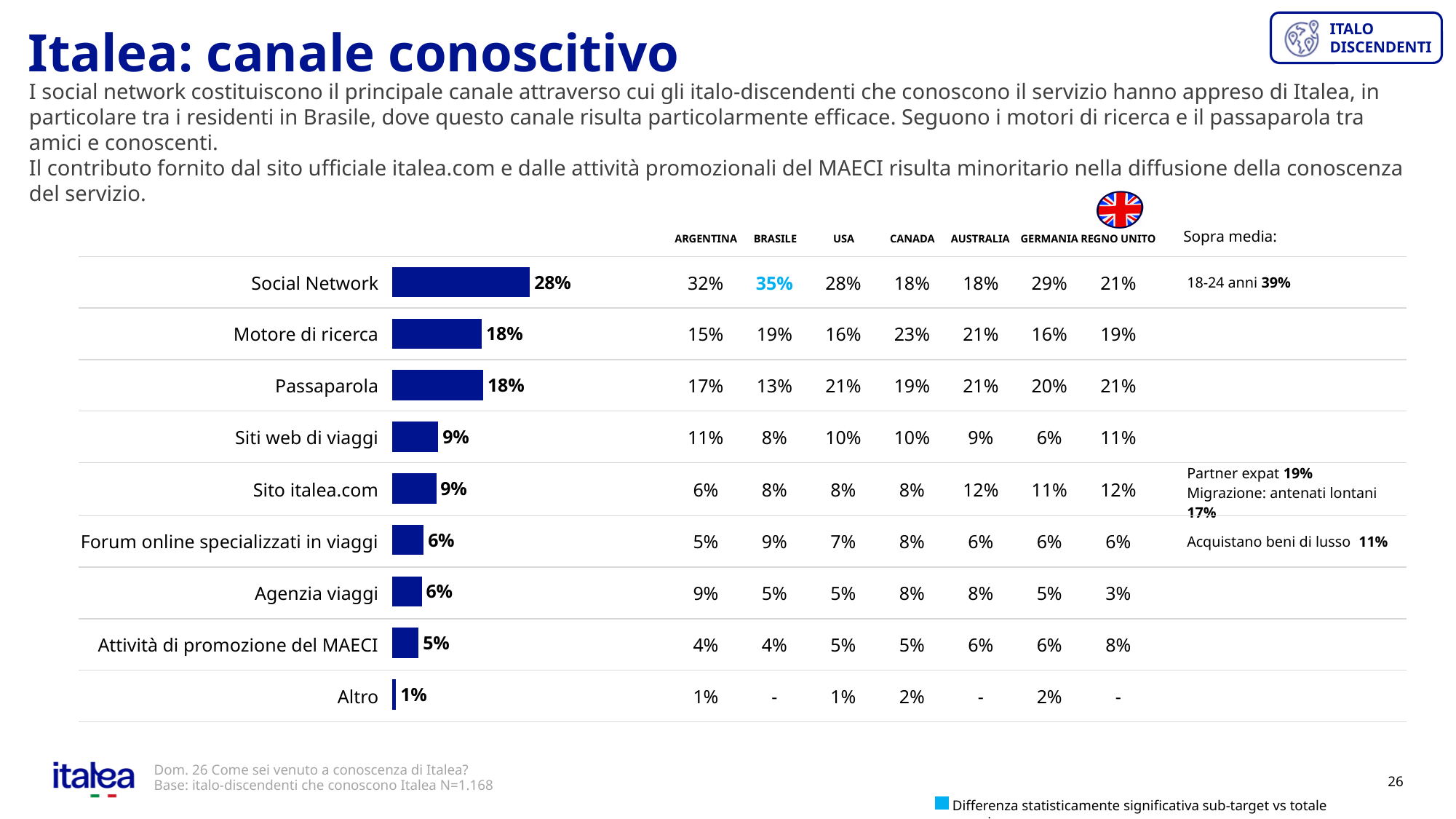
What is the value for Social Network in the bar chart? 28% Do the bar values rise or fall going from the top category to the bottom category? Fall What is the value for Attività di promozione del MAECI in the bar chart? 5% What is the value for Sito italea.com in the bar chart? 9% Which category has the lowest value in the bar chart? Altro What colour are the bars in the chart? Dark blue What is the difference between the values for Passaparola and Altro in the bar chart? 17% Which is larger in the bar chart: Siti web di viaggi or Agenzia viaggi? Siti web di viaggi Which category has the highest value in the bar chart? Social Network What kind of chart is shown on the slide? Bar chart How many categories are shown in the bar chart? 9 What is the difference between the values for Social Network and Motore di ricerca in the bar chart? 10%